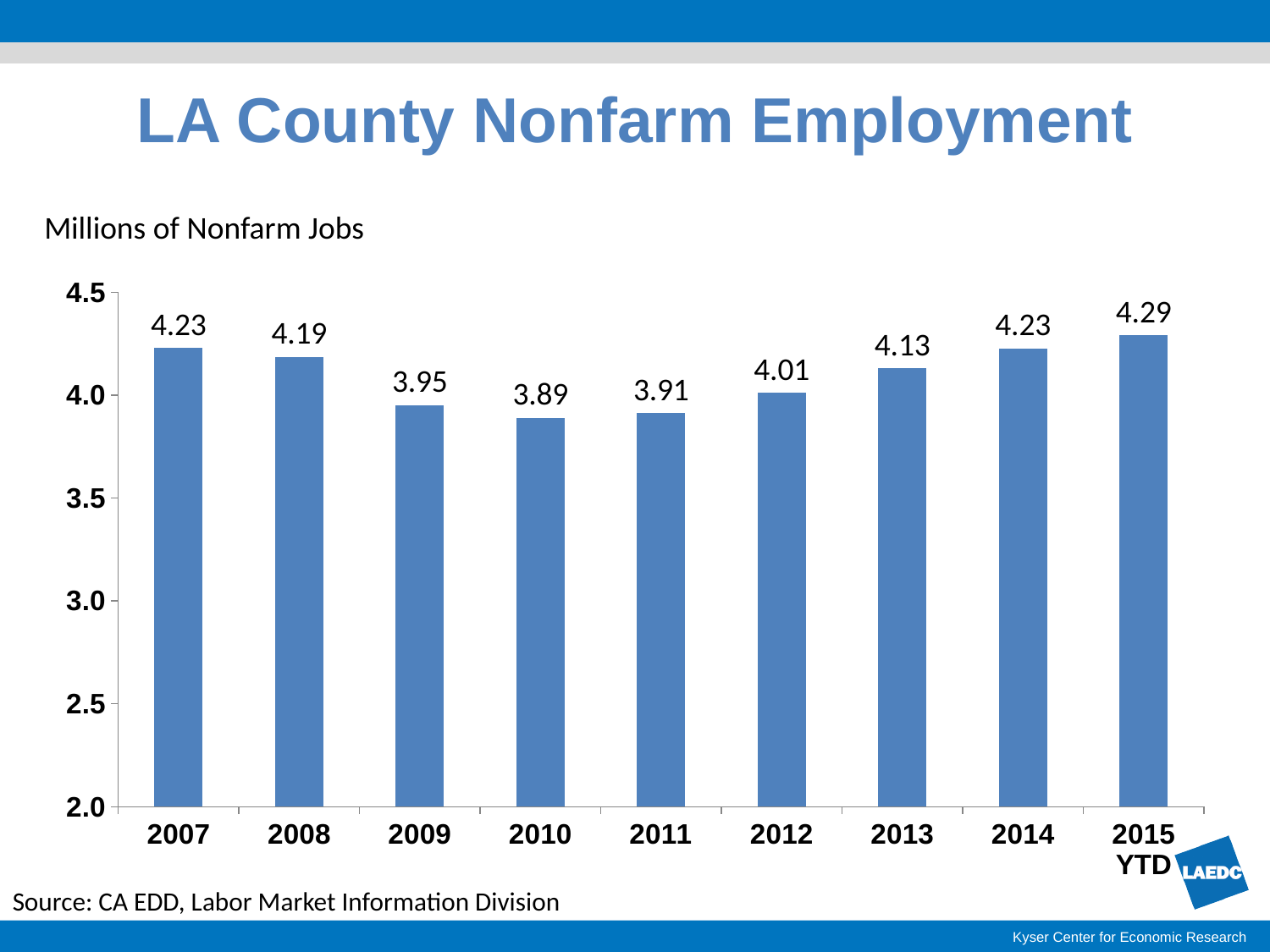
Which year has the lowest value? 2010 Is the value for 2011 greater or less than 4.0? less Which year has the highest value? 2015 YTD What is the value for 2015 YTD? 4.29 How many years are shown on the x axis? 9 What is the value for 2007? 4.23 Which is larger, the value for 2009 or the value for 2012? 2012 What is the value for 2010? 3.89 Do the values rise or fall from 2010 to 2015 YTD? rise What is the title of the chart? LA County Nonfarm Employment What is the difference between the values for 2015 YTD and 2010? 0.40 What kind of chart is this? bar chart